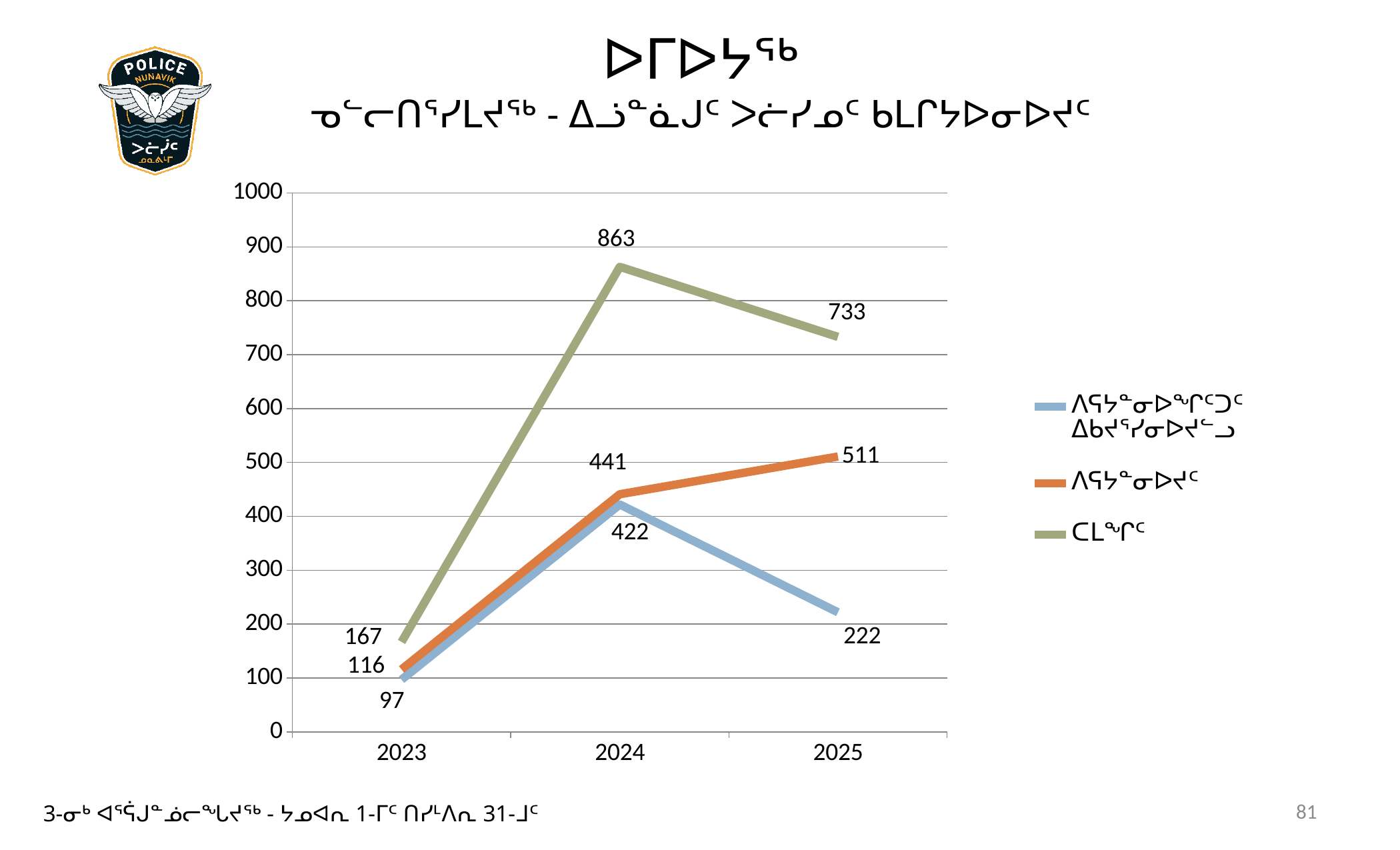
How many series does the legend list? 3 By how much does the green line fall from 2024 to 2025? 130 In 2025, which line has the larger value, the blue line or the orange line? the orange line What kind of chart is shown on the slide? line chart Does the orange line rise or fall from 2023 to 2025? rises What is the value of the blue line in 2023? 97 What is the value of the green line in 2024? 863 What is the difference between the orange line's values in 2024 and 2023? 325 What is the value of the orange line in 2025? 511 How many years are plotted along the x axis? 3 In which year does the green line reach its highest value? 2024 In which year is the blue line at its lowest value? 2023